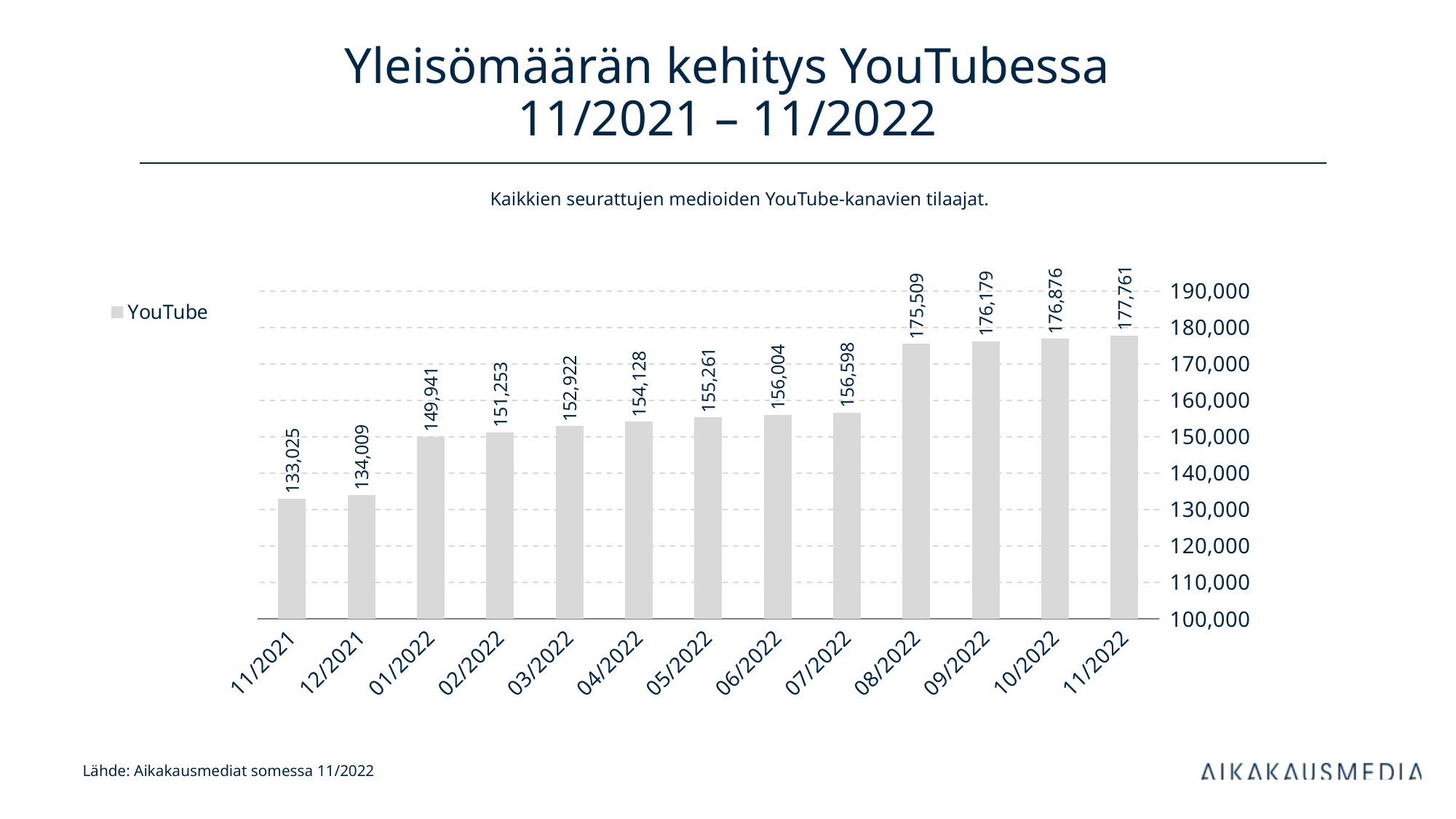
What is the value for 08/2022? 175,509 Which is larger, the value for 01/2022 or the value for 12/2021? 01/2022 Do the values rise or fall from 11/2021 to 11/2022? rise Which month has the highest value? 11/2022 What is the difference between the values for 11/2022 and 11/2021? 44,736 Which month has the lowest value? 11/2021 What is the difference between the values for 08/2022 and 07/2022? 18,911 Is the value for 06/2022 greater or less than 150,000? greater What is the value for 03/2022? 152,922 What is the value for 11/2021? 133,025 How many months are shown on the x axis? 13 What kind of chart is shown on the slide? bar chart